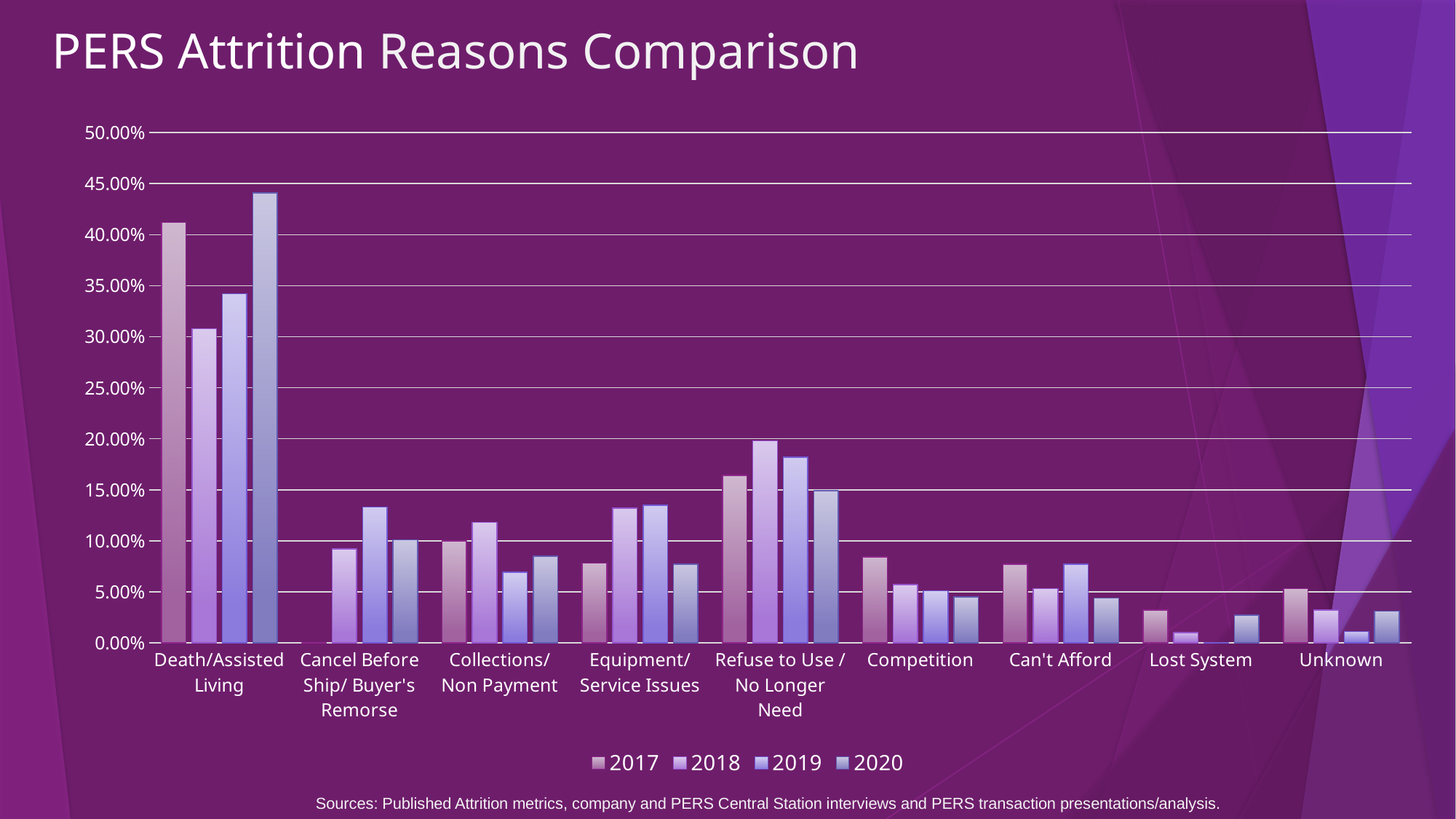
For Refuse to Use / No Longer Need, which is larger: the 2018 value or the 2020 value? 2018 What are the entries listed in the legend? 2017, 2018, 2019, 2020 For Death/Assisted Living, which year has the lowest value? 2018 What kind of chart is shown on the slide? Bar chart Is the 2019 value for Cancel Before Ship/ Buyer's Remorse greater or less than 10.00%? greater Which category has the highest value for 2020? Death/Assisted Living Do the values for Competition rise or fall from 2017 to 2020? fall How many attrition reason categories are shown on the x axis? 9 For Death/Assisted Living, which is larger: the 2017 value or the 2020 value? 2020 Is the 2018 value for Refuse to Use / No Longer Need greater or less than 15.00%? greater How many series does the legend list? 4 Is the 2020 value for Death/Assisted Living greater or less than 40.00%? greater